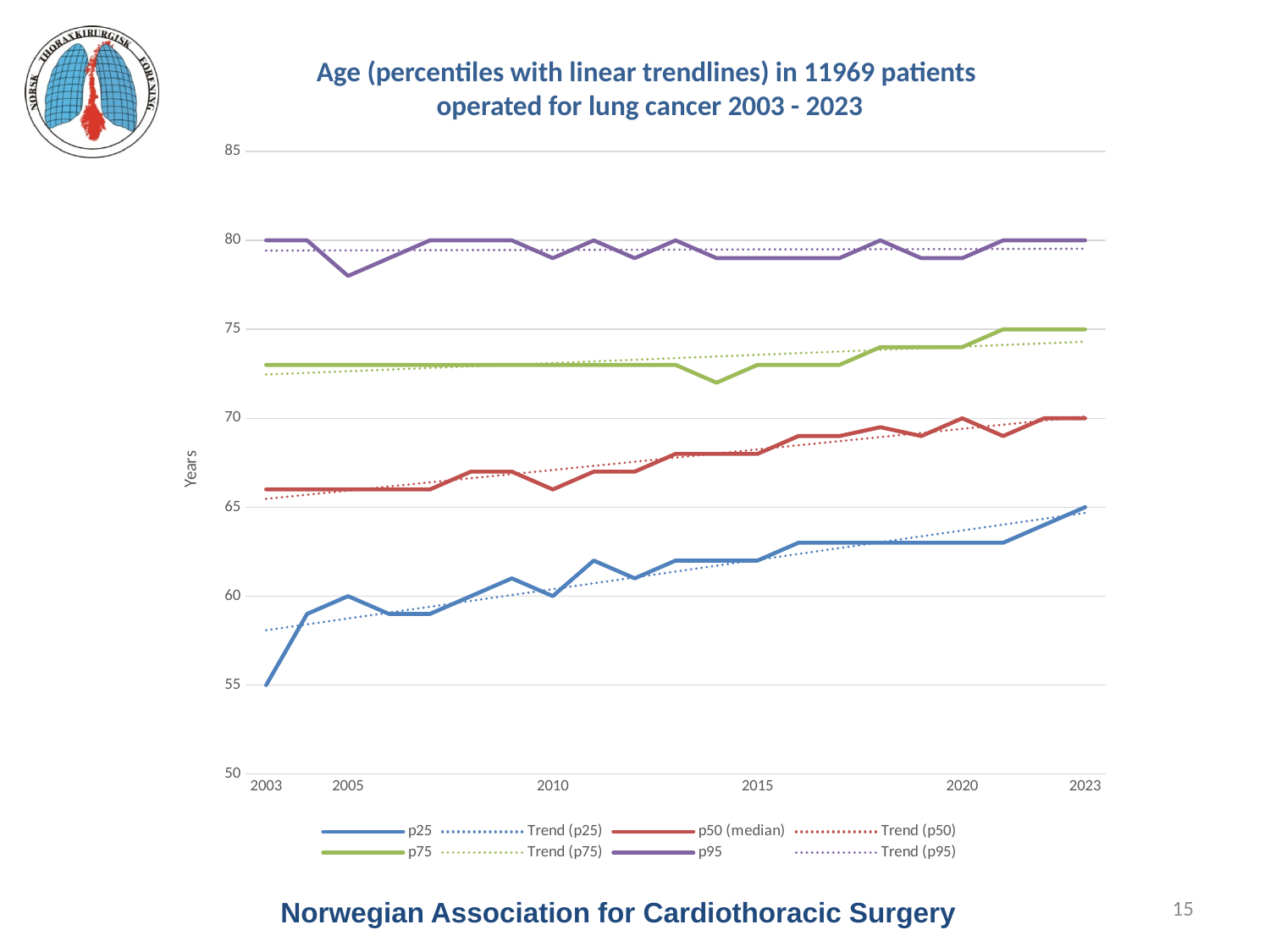
How many series does the legend list? 8 What is the p25 value in 2023? 65 What is the p50 (median) value in 2023? 70 What is the label on the vertical axis? Years What is the p75 value in 2023? 75 Is the p50 (median) value in 2003 greater or less than 65? greater Is the p95 value in 2005 greater or less than 80? less Does the p25 series generally rise or fall from 2003 to 2023? rise By how much did the p25 value increase from 2003 to 2023? 10 What is the p25 value in 2003? 55 What kind of chart is shown on the slide? line chart What is the p95 value in 2003? 80